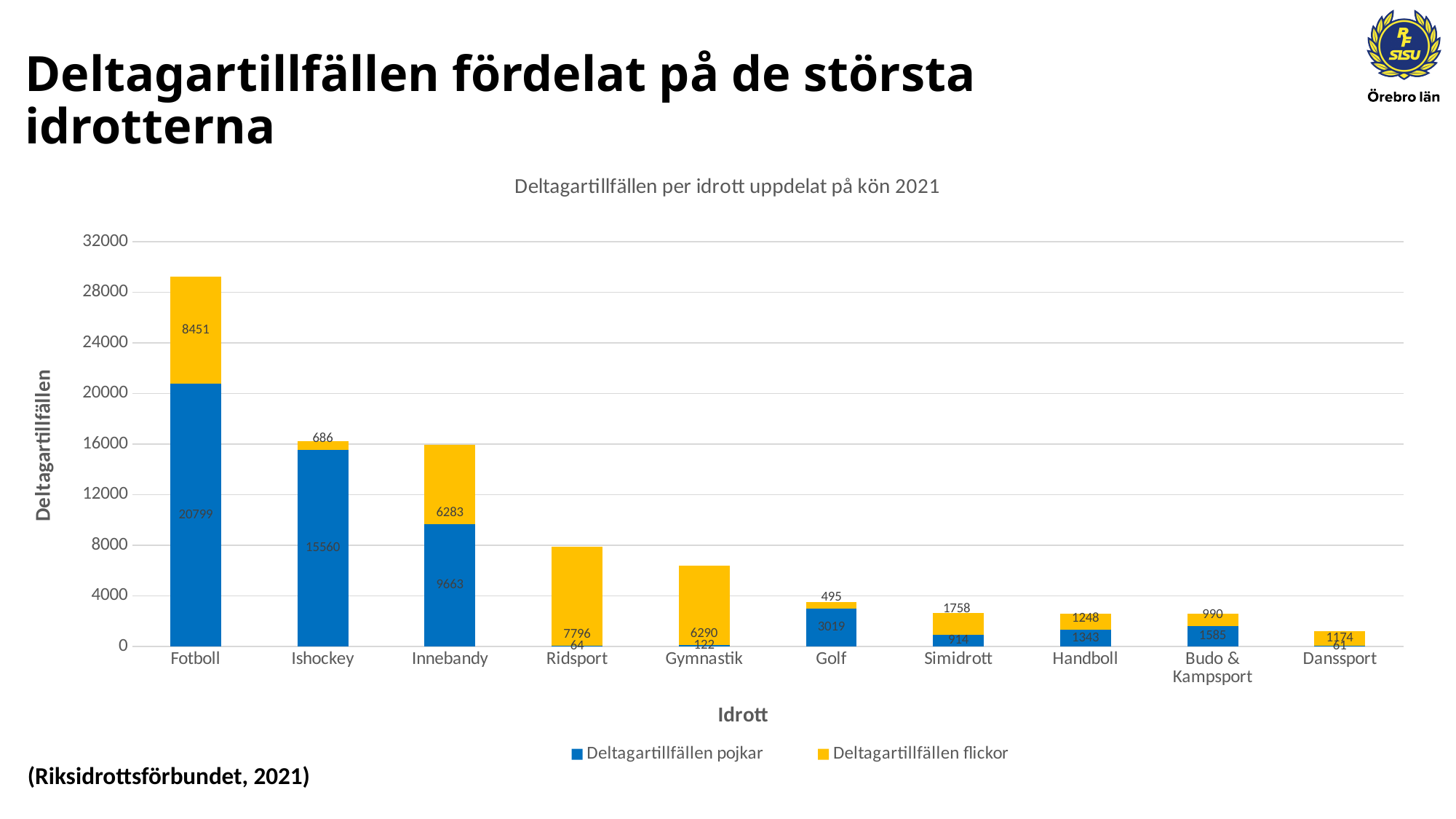
What is the value for Deltagartillfällen flickor for Ishockey? 686 How many sports are shown on the x axis? 10 Which sport has the lowest value for Deltagartillfällen pojkar? Danssport Which sport has the highest value for Deltagartillfällen flickor? Fotboll How many series does the legend list? 2 What is the value for Deltagartillfällen flickor for Ridsport? 7796 What is the total of the stacked bar for Fotboll? 29250 What is the value for Deltagartillfällen pojkar for Fotboll? 20799 What kind of chart is shown on the slide? Stacked bar chart Which is larger for Handboll: Deltagartillfällen pojkar or Deltagartillfällen flickor? Deltagartillfällen pojkar What is the difference between Deltagartillfällen pojkar and Deltagartillfällen flickor for Innebandy? 3380 What is the total of the stacked bar for Golf? 3514